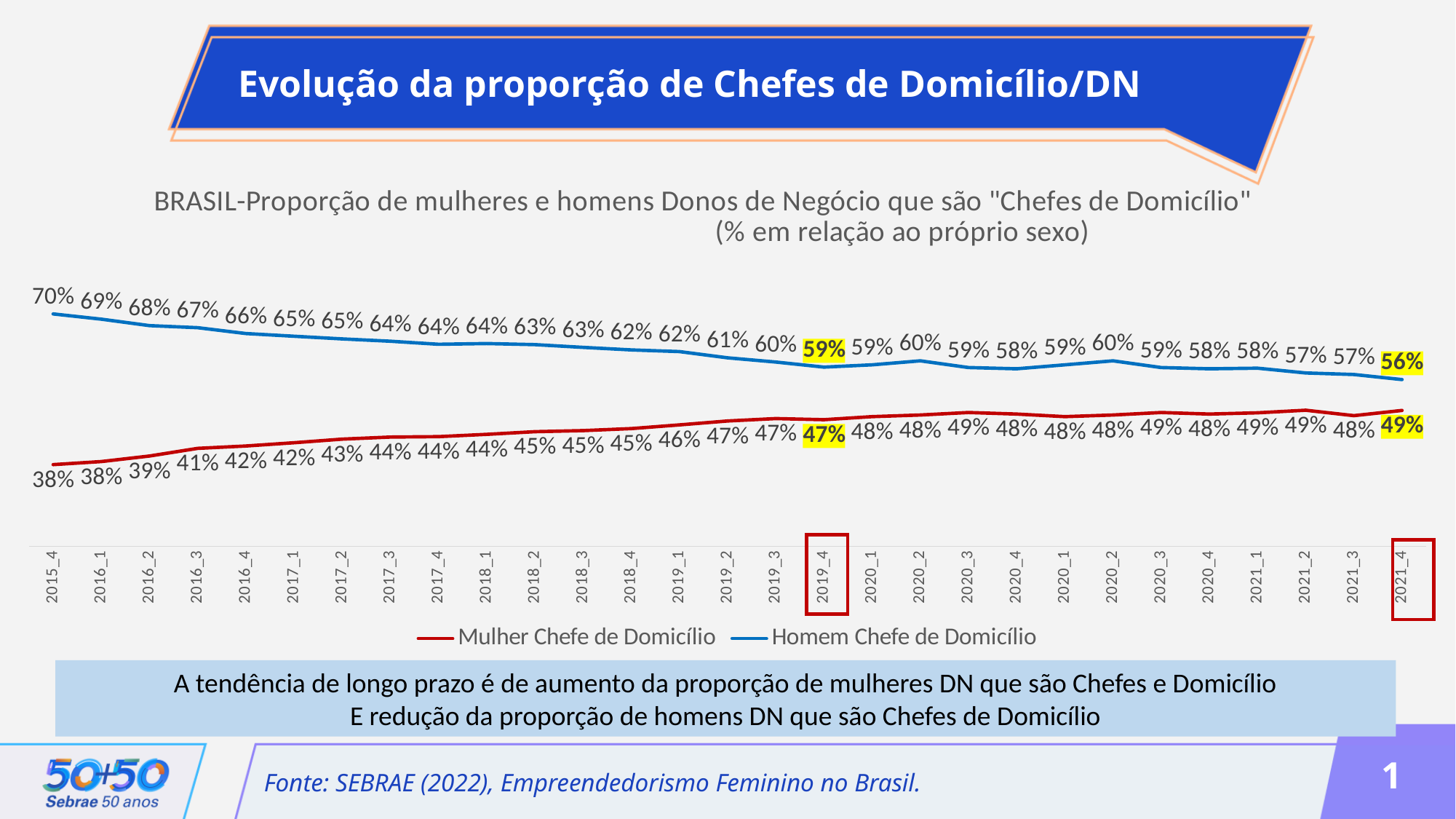
How many series does the legend list? 2 What kind of chart is shown on the slide? line chart What is the value for Homem Chefe de Domicílio at 2015_4? 70% What is the value for Mulher Chefe de Domicílio at 2019_4? 47% What is the difference between the Homem and Mulher values at 2015_4? 32 percentage points What colour is the line for Mulher Chefe de Domicílio? red What is the value for Homem Chefe de Domicílio at 2019_4? 59% What is the value for Homem Chefe de Domicílio at 2021_4? 56% What is the value for Mulher Chefe de Domicílio at 2015_4? 38% Does the Homem Chefe de Domicílio series rise or fall from 2015_4 to 2021_4? fall What is the difference between the Homem and Mulher values at 2021_4? 7 percentage points What is the value for Mulher Chefe de Domicílio at 2021_4? 49%